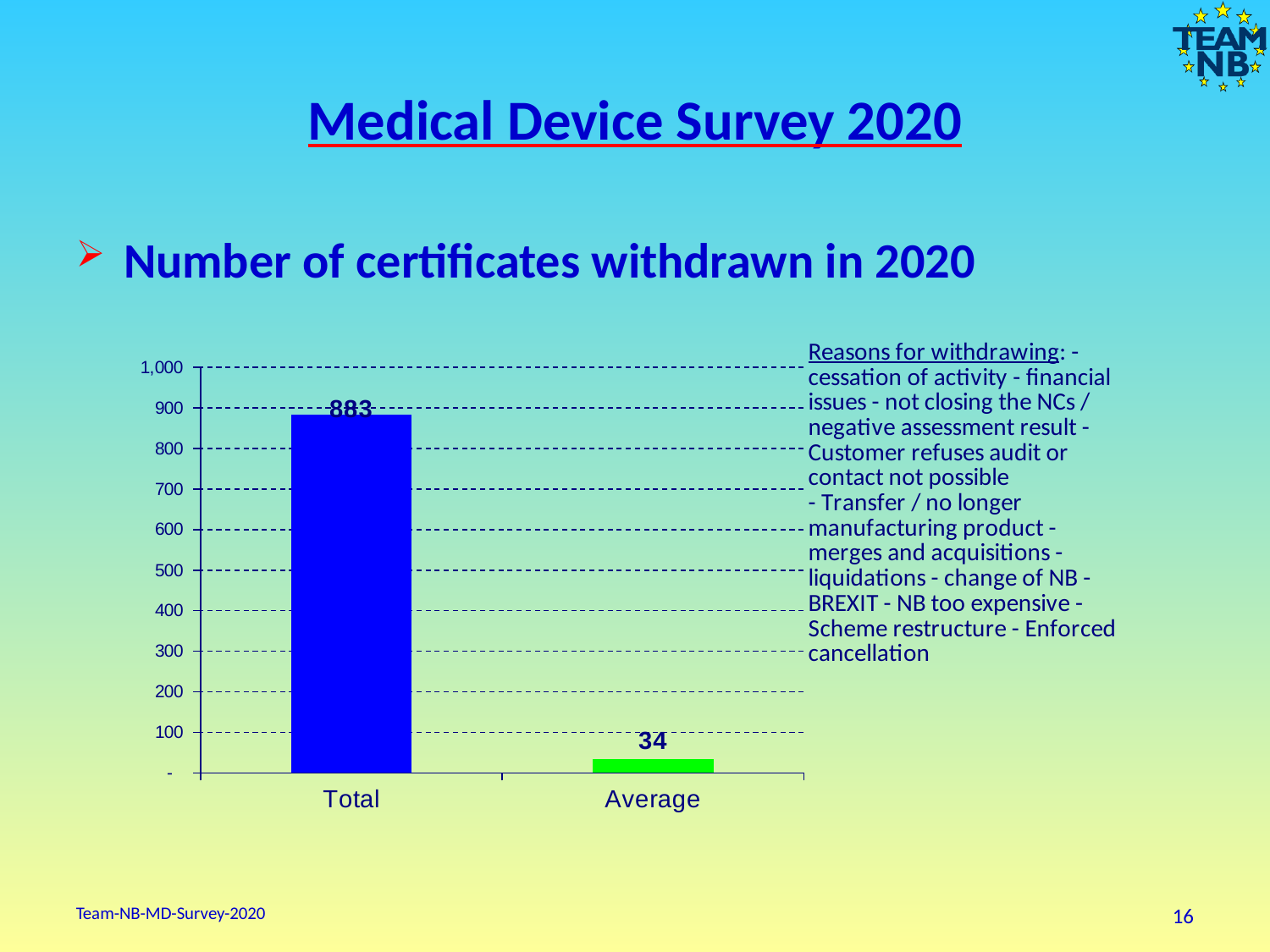
Is the value for Average greater or less than 100? less What is the value of the Average bar? 34 How many categories are shown on the x axis? 2 Which category has the lowest value? Average What kind of chart is shown on the slide? bar chart What is the value of the Total bar? 883 What is the highest value shown on the y axis? 1,000 What is the difference between the Total and Average values? 849 Is the value for Total greater or less than 800? greater What colour is the Total bar? blue Which is larger, the Total value or the Average value? Total Which category has the highest value? Total